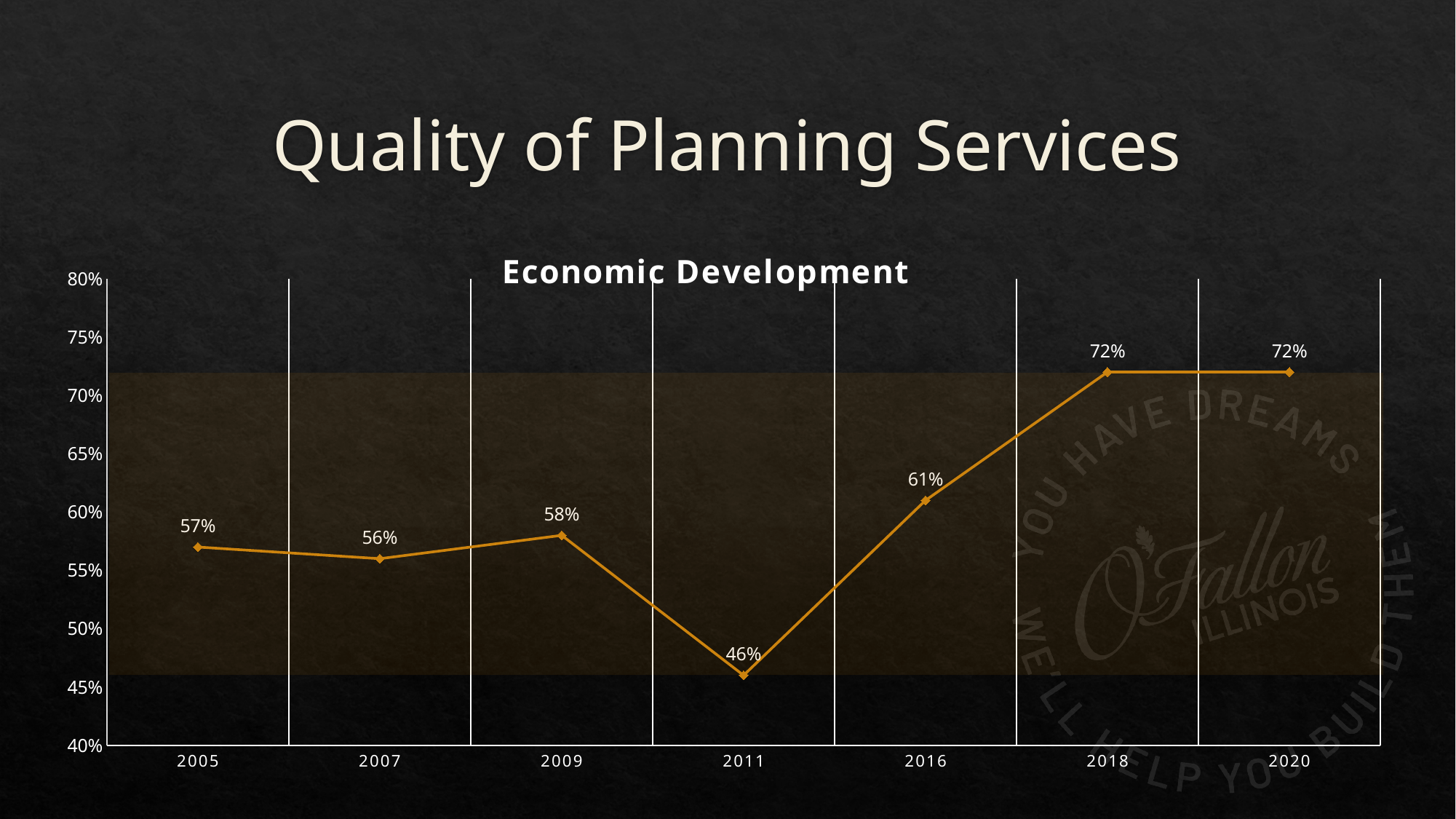
What is the value for 2005? 57% What is the value for 2011? 46% What kind of chart is shown? line chart What is the difference between the values for 2009 and 2007? 2% Is the value for 2011 greater or less than 50%? less How many years are plotted on the chart? 7 What is the value for 2020? 72% What is the value for 2016? 61% What is the difference between the values for 2018 and 2011? 26% Which is larger, the value for 2016 or the value for 2009? 2016 Which year has the lowest value? 2011 What is the title of the chart? Economic Development